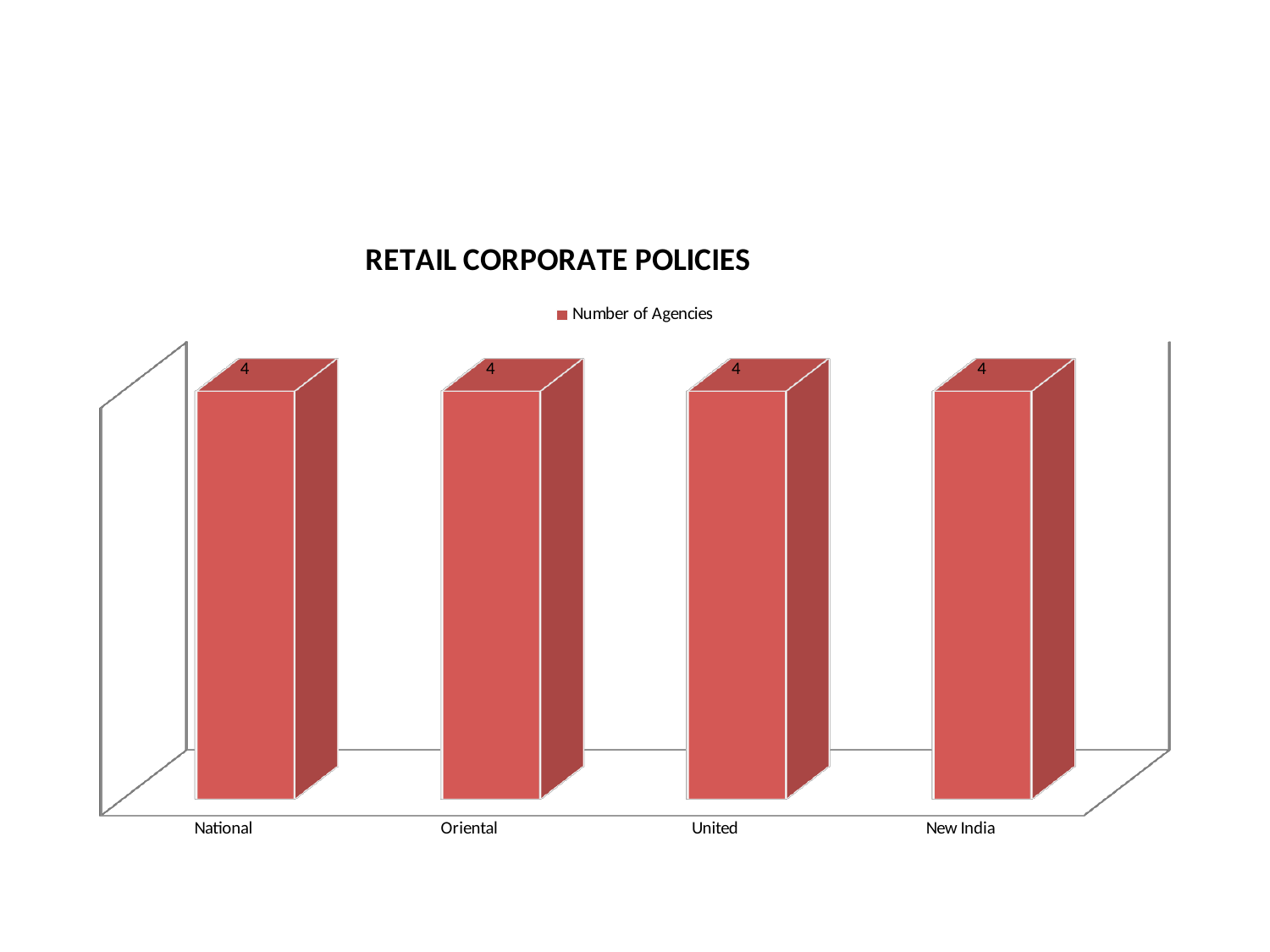
Do the values rise, fall, or stay the same across the categories from National to New India? stay the same How many categories are shown on the x axis? 4 What is the Number of Agencies for National? 4 How many series does the legend list? 1 What is the Number of Agencies for New India? 4 What is the title of the chart? RETAIL CORPORATE POLICIES What series name is shown in the legend? Number of Agencies What is the Number of Agencies for United? 4 What is the Number of Agencies for Oriental? 4 What is the difference between the Number of Agencies for National and for New India? 0 What kind of chart is shown on the slide? bar chart